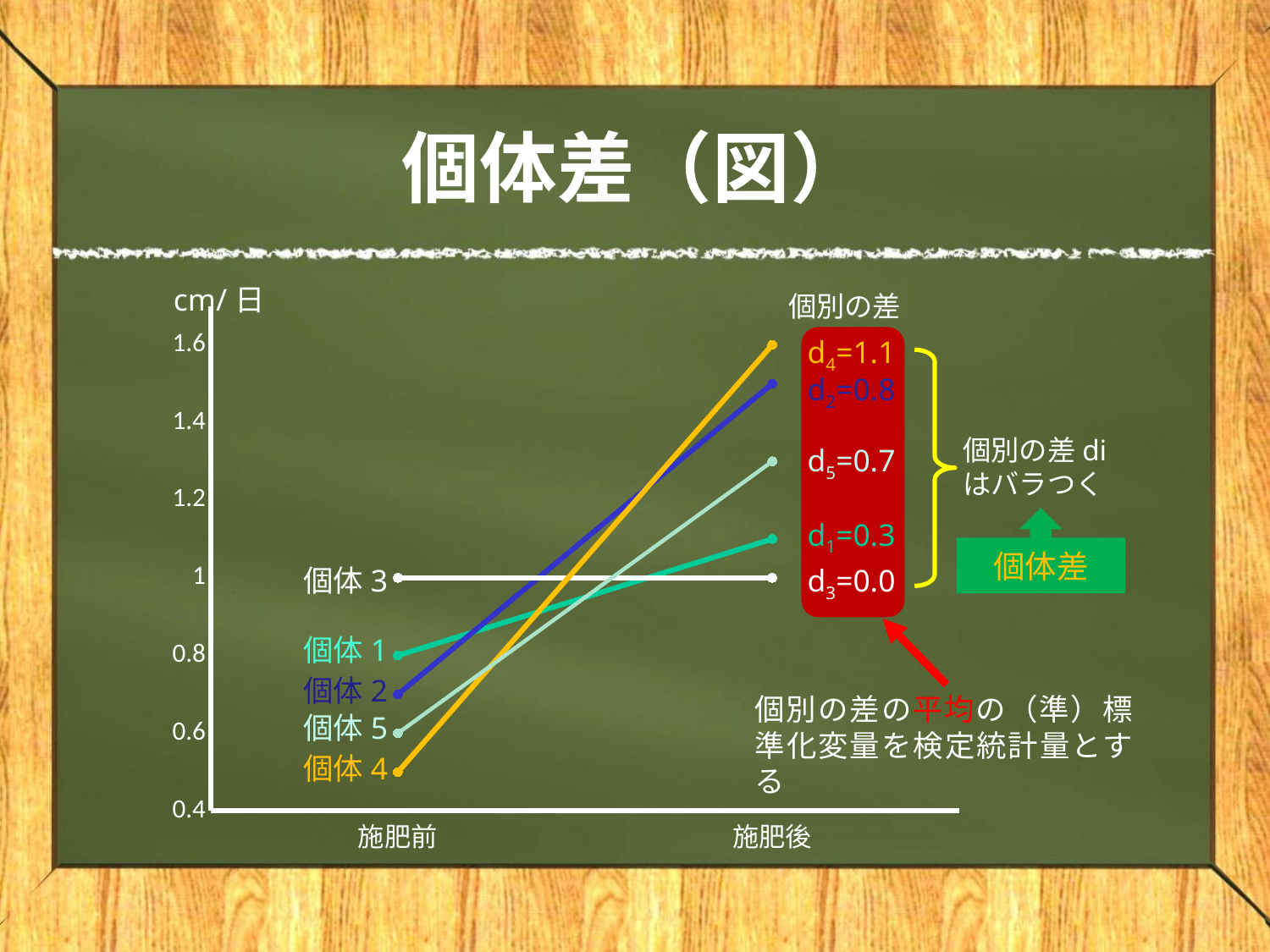
What kind of chart is shown on the slide? line chart What unit is shown on the y axis of the chart? cm/日 Does the line for 個体3 rise, fall, or stay flat from 施肥前 to 施肥後? stays flat What is the difference between d4 and d2? 0.3 What is the individual difference d3 shown in the red box? 0.0 Which is larger, d5 or d1? d5 How many individuals (個体) are plotted in the chart? 5 Which individual has the smallest individual difference (個別の差)? 個体3 How many categories are shown on the x axis of the chart? 2 Which individual has the largest individual difference (個別の差)? 個体4 Is the value for 個体2 at 施肥後 greater or less than 1.4? greater What is the individual difference d4 shown in the red box? 1.1